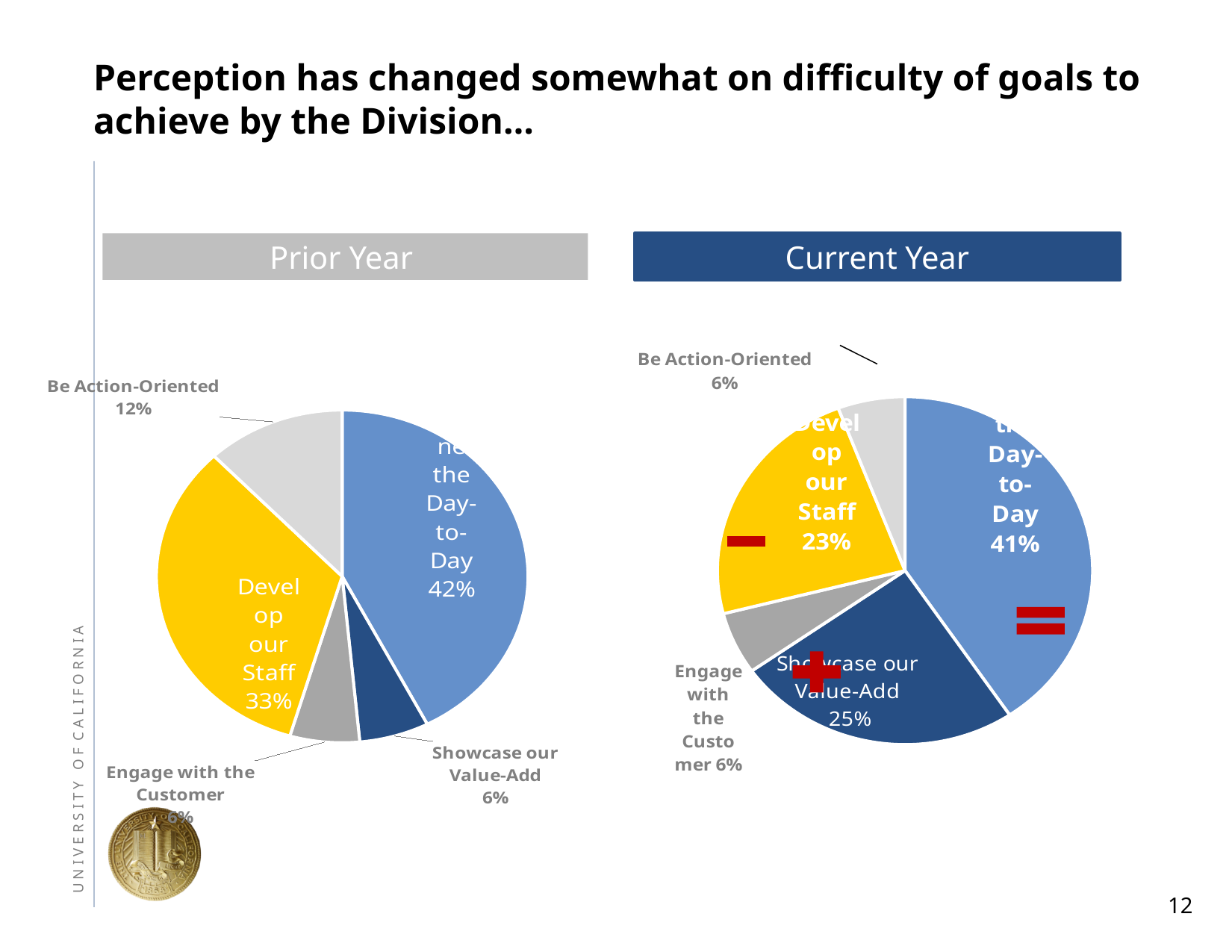
By how many percentage points did the share for Showcase our Value-Add change from the Prior Year pie chart to the Current Year pie chart? 19 percentage points In the Prior Year pie chart, what share is shown for Showcase our Value-Add? 6% In the Current Year pie chart, what percentage is shown on the largest slice? 41% In the Current Year pie chart, what share is shown for Be Action-Oriented? 6% In the Prior Year pie chart, what percentage is shown on the largest slice? 42% In the Prior Year pie chart, what share is shown for Develop our Staff? 33% Which pie chart shows a larger share for Develop our Staff, Prior Year or Current Year? Prior Year What kind of charts are shown on the slide? Pie charts In the Current Year pie chart, what share is shown for Showcase our Value-Add? 25% In the Current Year pie chart, what share is shown for Develop our Staff? 23% In the Prior Year pie chart, what share is shown for Be Action-Oriented? 12% How many slices does the Current Year pie chart have? 5